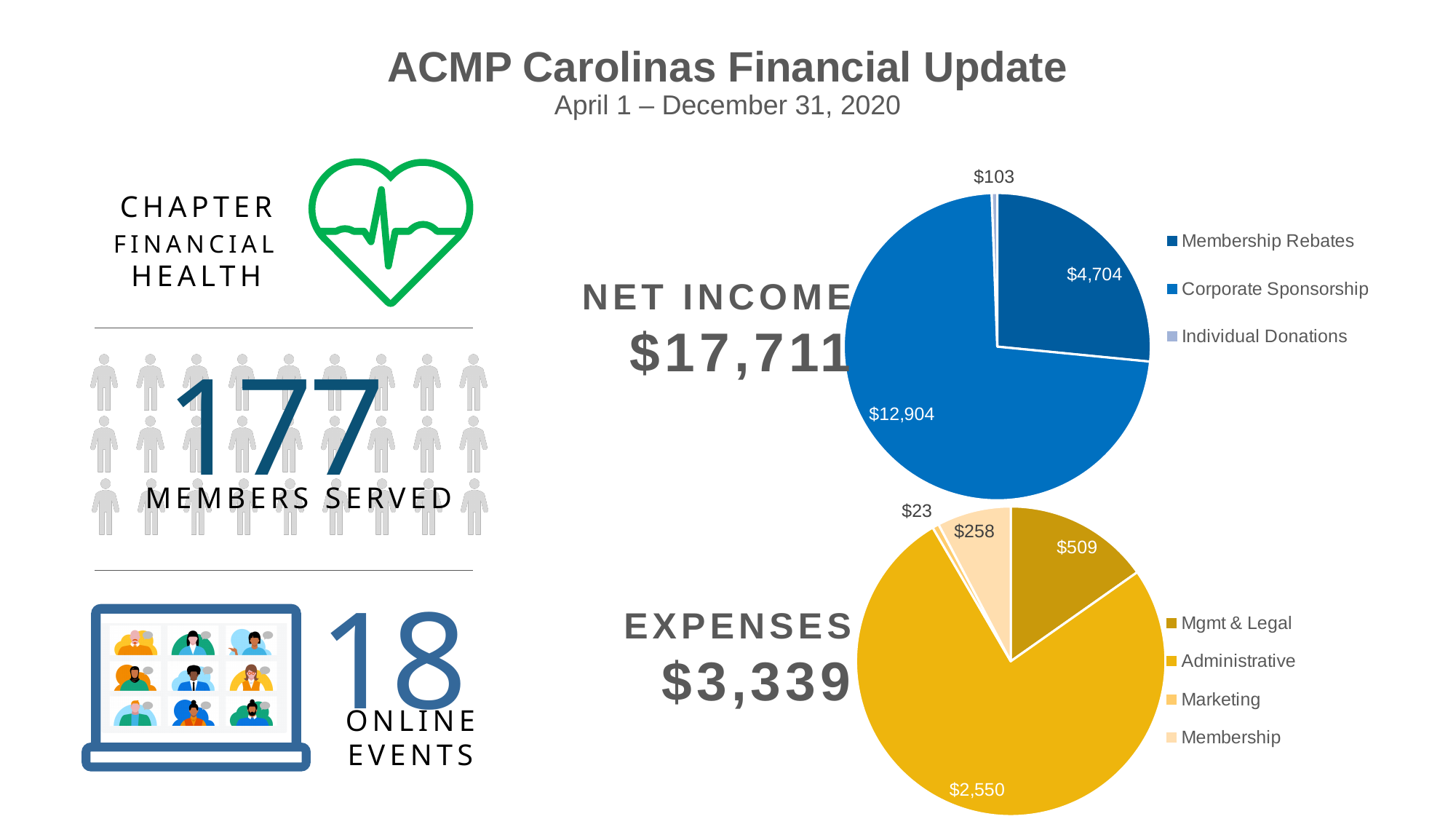
In the Net Income pie chart, what is the value for Membership Rebates? $4,704 How many slices does the Expenses pie chart have? 4 In the Expenses pie chart, what is the value for Administrative? $2,550 In the Expenses pie chart, which is larger, Marketing or Mgmt & Legal? Mgmt & Legal In the Net Income pie chart, what is the value for Individual Donations? $103 How many categories does the legend of the Net Income pie chart list? 3 In the Expenses pie chart, what is the value for Mgmt & Legal? $509 In the Net Income pie chart, which category is the largest? Corporate Sponsorship In the Net Income pie chart, what is the value for Corporate Sponsorship? $12,904 What type of chart is used for the Net Income breakdown? pie chart In the Expenses pie chart, which category is the smallest? Marketing In the Net Income pie chart, what is the difference between Corporate Sponsorship and Membership Rebates? $8,200